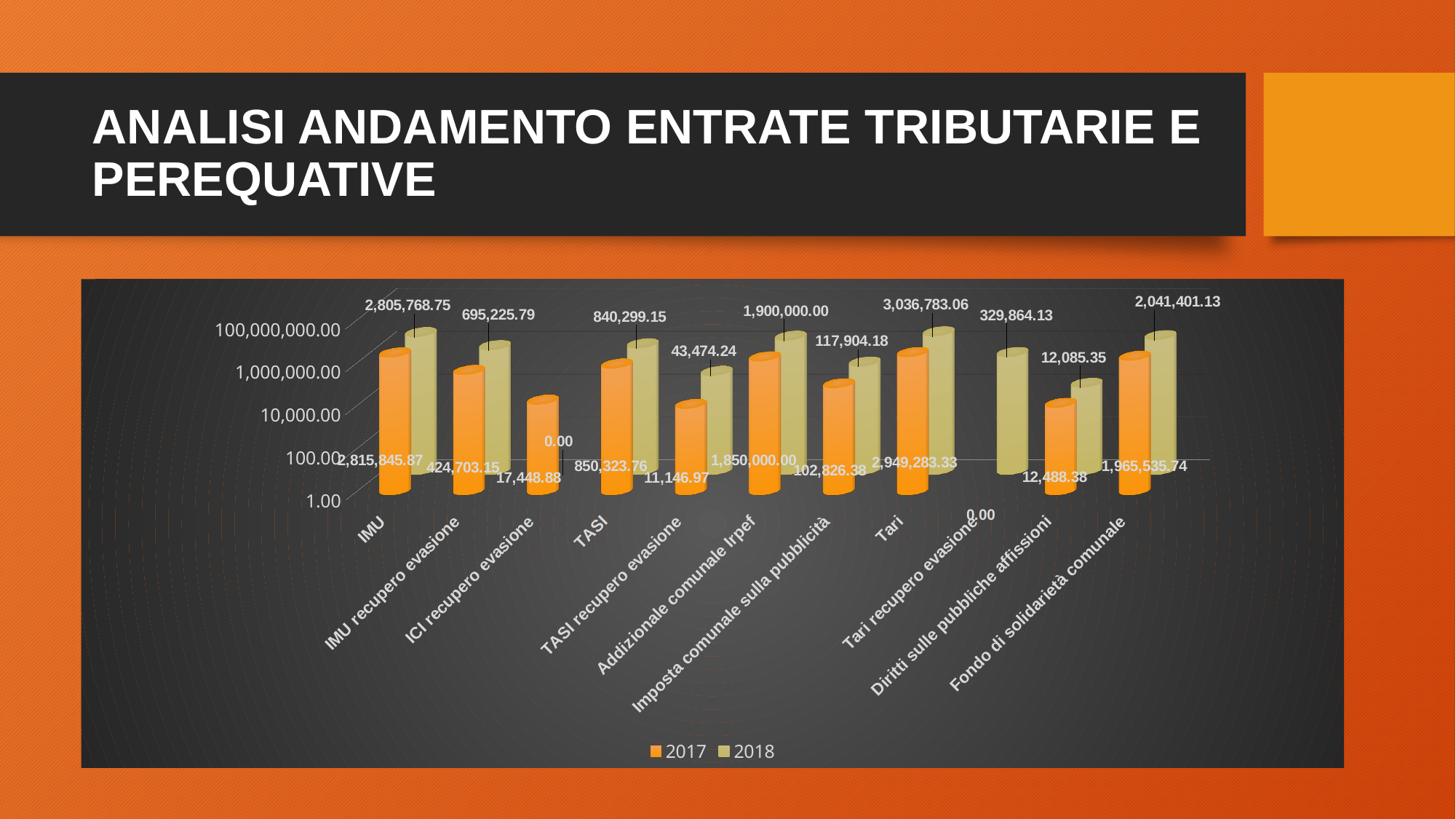
What is the 2018 value for ICI recupero evasione? 0.00 What kind of chart is shown on the slide? Bar chart What is the 2018 value for Tari recupero evasione? 329,864.13 How many series does the legend list? 2 How many categories are shown on the x axis? 11 Which is larger for IMU recupero evasione, the 2017 value or the 2018 value? 2018 Which category has the lowest 2017 value? Tari recupero evasione Which category has the highest 2018 value? Tari What is the difference between the 2018 and 2017 values for Addizionale comunale Irpef? 50,000.00 What is the 2017 value for IMU? 2,815,845.87 What is the 2017 value for Fondo di solidarietà comunale? 1,965,535.74 Which series is shown in orange according to the legend? 2017